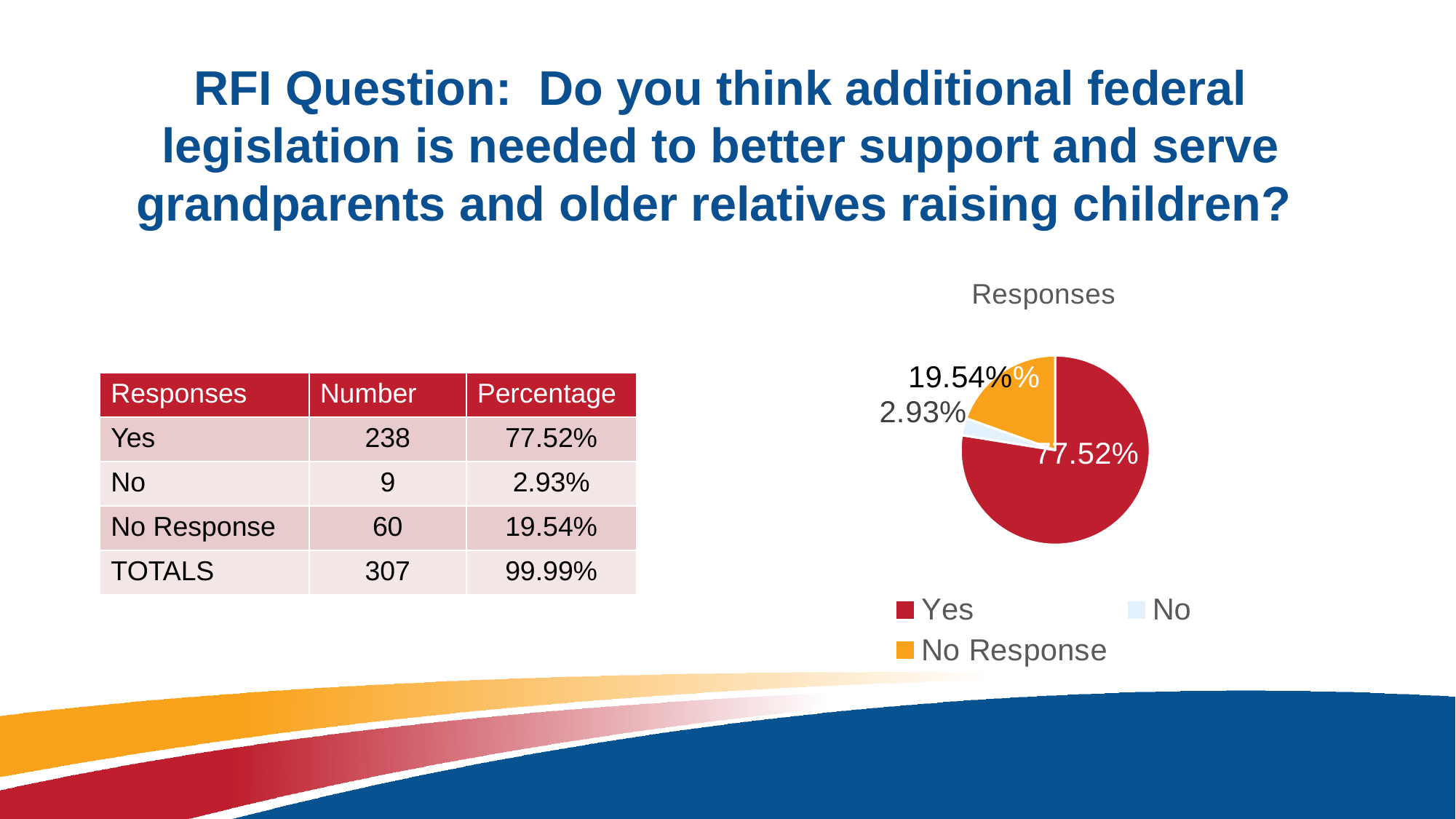
How many entries does the pie chart legend list? 3 What percentage does the Yes slice of the pie chart show? 77.52% What percentage does the No Response slice of the pie chart show? 19.54% What kind of chart is shown on the slide? pie chart Which category has the smallest slice in the pie chart? No What percentage does the No slice of the pie chart show? 2.93% What is the title of the pie chart? Responses What colour is the No Response slice in the pie chart? orange Which slice is larger in the pie chart, No or No Response? No Response Which category has the largest slice in the pie chart? Yes How many slices does the pie chart have? 3 What is the difference in percentage points between the Yes slice and the No Response slice? 57.98